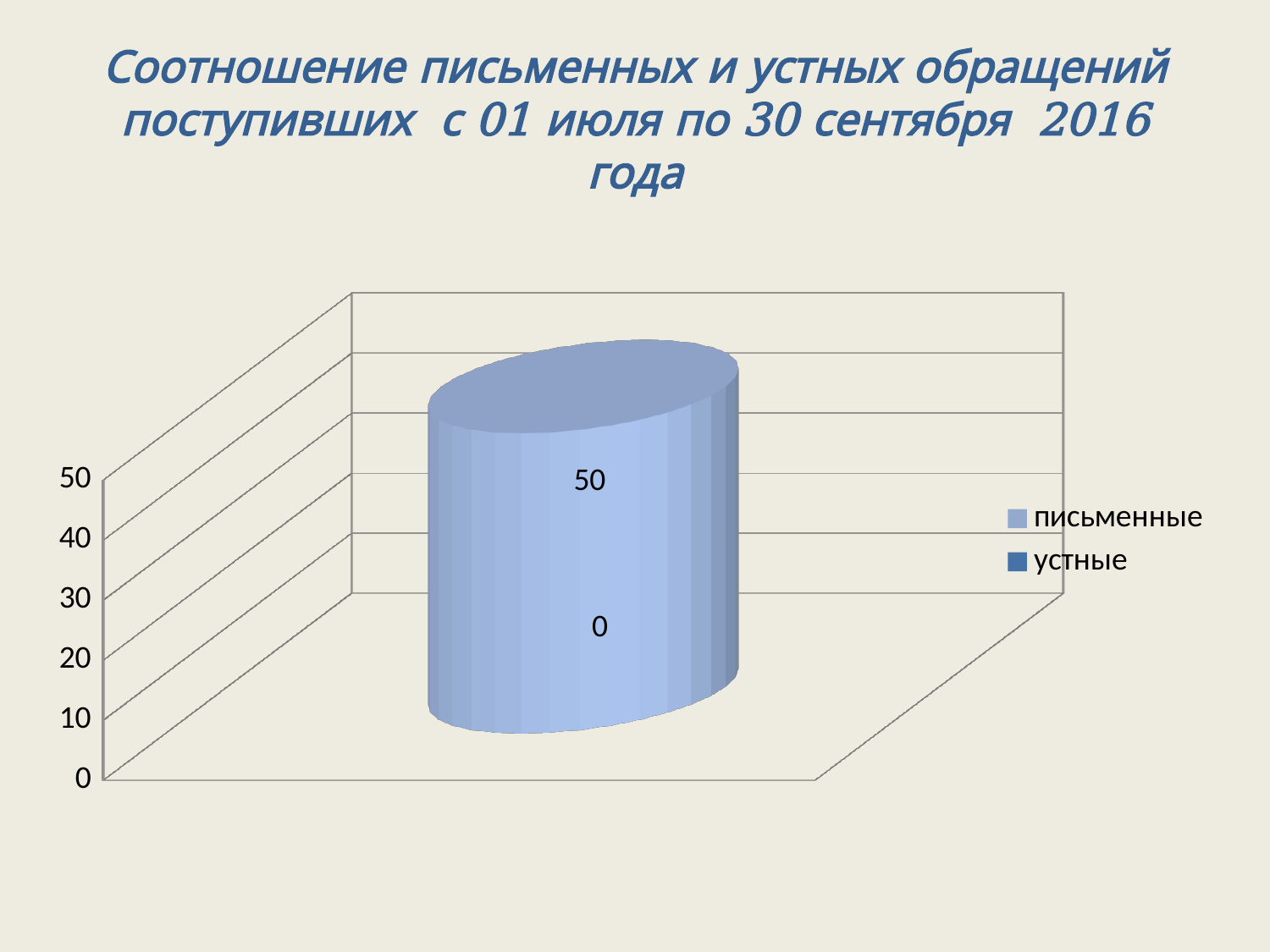
How many series does the legend list? 2 What is the total of the values for письменные and устные? 50 Which series has the highest value? письменные Which series has the lowest value? устные What is the value for письменные? 50 What is the value for устные? 0 What kind of chart is shown on the slide? bar chart What is the maximum value shown on the vertical axis? 50 What are the two legend entries of the chart? письменные, устные What is the difference between the values for письменные and устные? 50 Which series has the higher value, письменные or устные? письменные Is the value for письменные greater or less than 40? greater